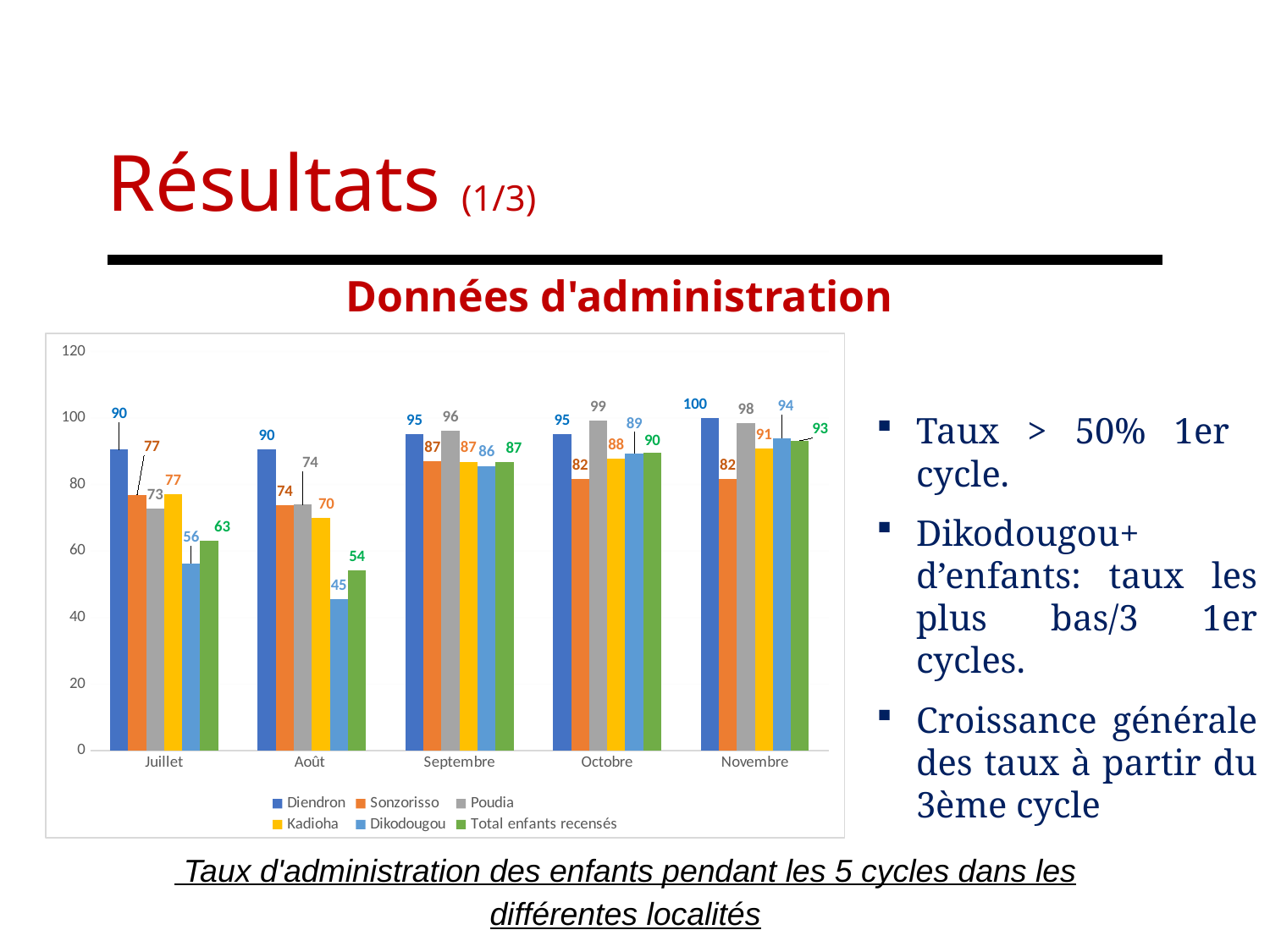
How many months are shown on the x axis? 5 Does the value for Total enfants recensés rise or fall from Août to Novembre? Rise Which series has the lowest value in Août? Dikodougou What is the value for Dikodougou in Août? 45 What kind of chart is shown? Bar chart Which is larger in Septembre, the value for Poudia or the value for Sonzorisso? Poudia What is the value for Diendron in Novembre? 100 Which series has the highest value in Octobre? Poudia How many series does the legend list? 6 What is the difference between the Diendron and Dikodougou values in Juillet? 34 What is the value for Total enfants recensés in Juillet? 63 What is the value for Poudia in Octobre? 99